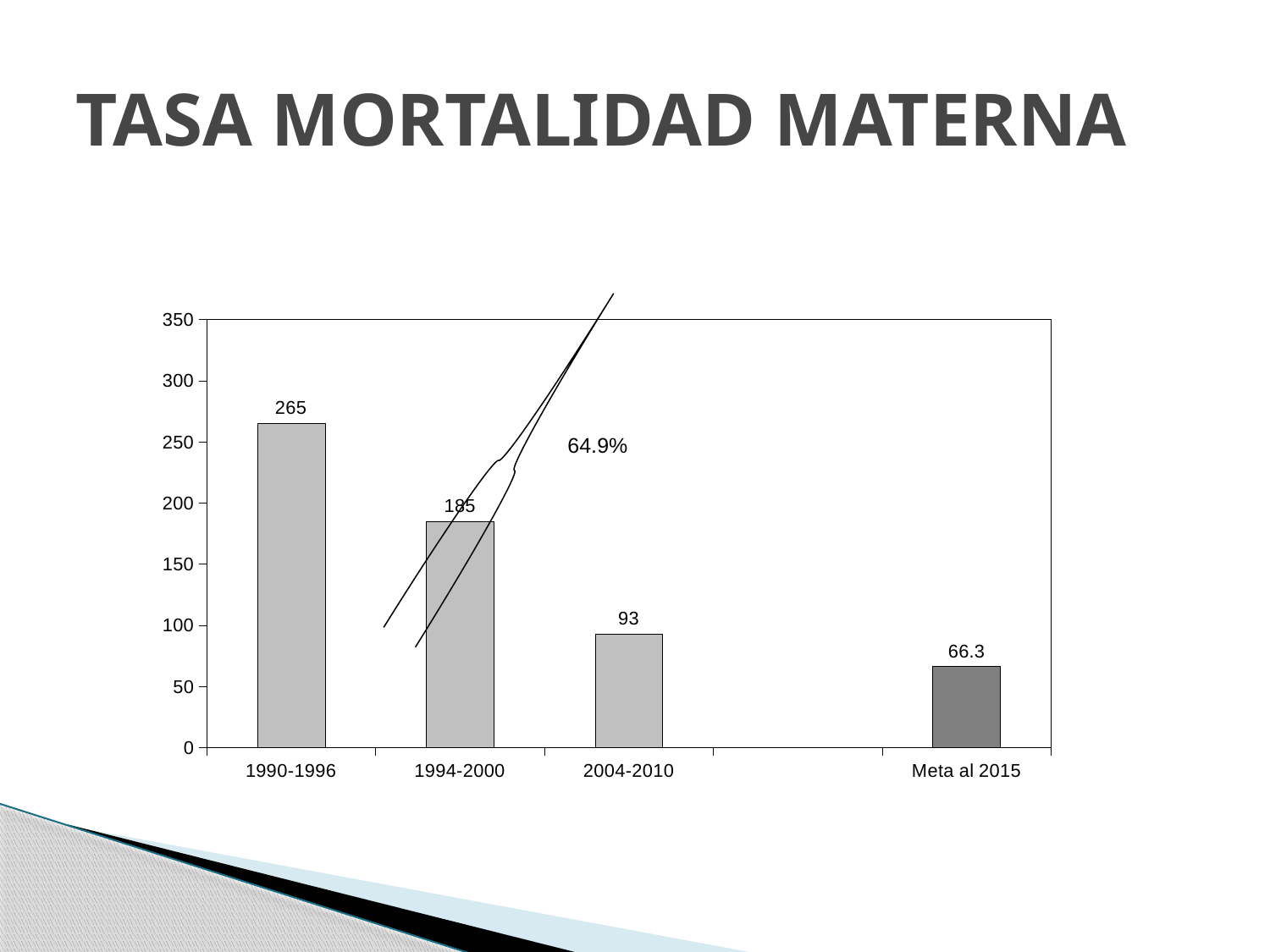
What is the value for 2004-2010? 93 What is the value for Meta al 2015? 66.3 How many bars are plotted in the chart? 4 Which category has the highest value? 1990-1996 What is the value for 1990-1996? 265 Which is larger, the value for 2004-2010 or the value for Meta al 2015? 2004-2010 What is the difference between the values for 1994-2000 and 2004-2010? 92 What kind of chart is shown on the slide? bar chart What is the value for 1994-2000? 185 What is the difference between the values for 1990-1996 and 1994-2000? 80 Which category has the lowest value? Meta al 2015 Do the values rise or fall from 1990-1996 to 2004-2010? fall